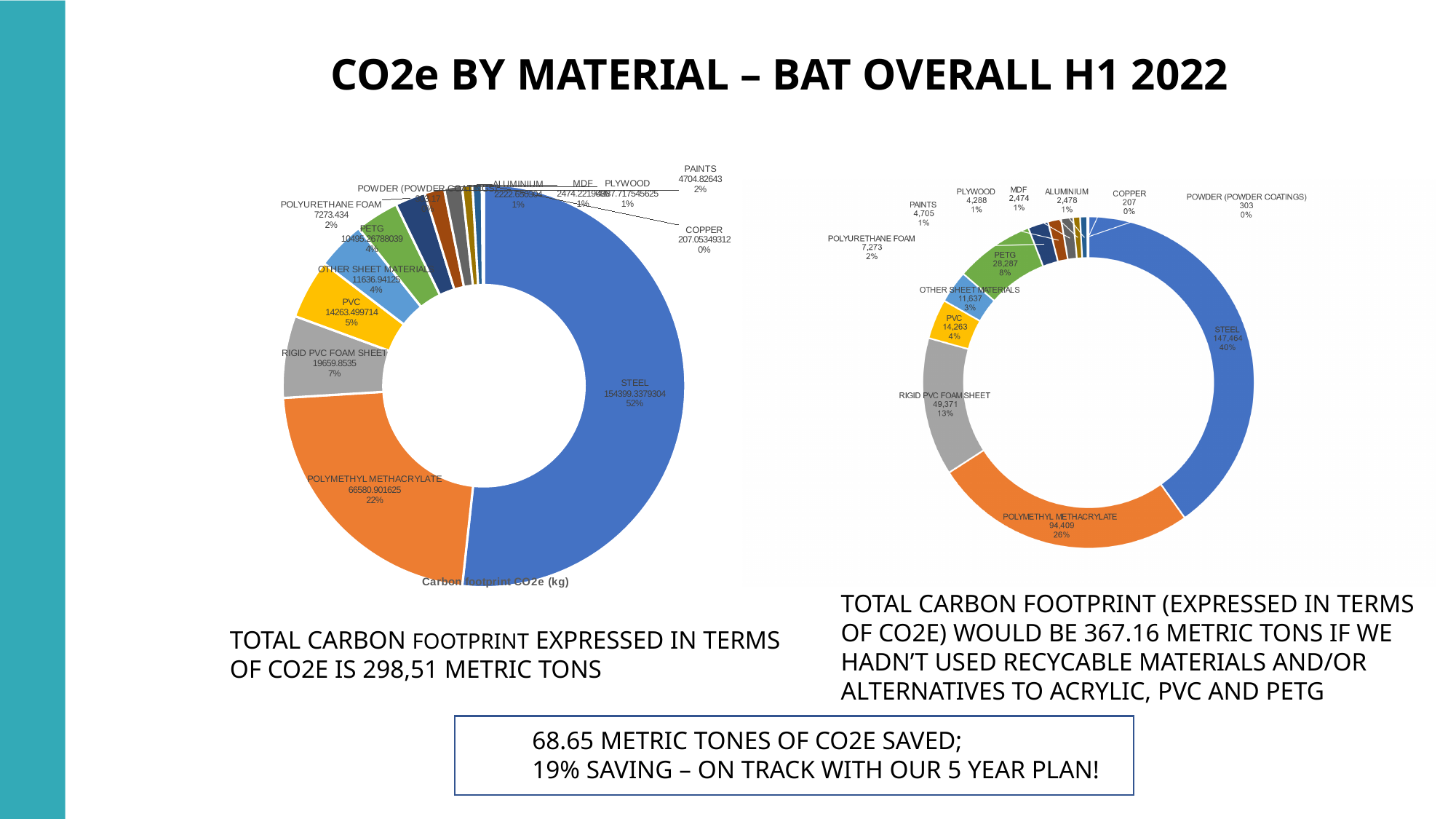
In the right-hand doughnut chart, what share of the total does POLYMETHYL METHACRYLATE represent? 26% What is the axis/series label printed below the left-hand doughnut chart? Carbon footprint CO2e (kg) In the left-hand doughnut chart, what percentage share does RIGID PVC FOAM SHEET have? 7% In the right-hand doughnut chart, which material has the largest slice? STEEL What type of chart is shown on the left of the slide? Doughnut (pie) chart In the right-hand doughnut chart, which is larger: the value for PLYWOOD or the value for MDF? PLYWOOD In the right-hand doughnut chart, which material has the smallest value? COPPER In the left-hand doughnut chart, what percentage share does STEEL have? 52% In the right-hand doughnut chart, what is the difference between the values for PETG and PVC? 14,024 In the right-hand doughnut chart, what is the value for STEEL? 147,464 In the right-hand doughnut chart, what is the value for RIGID PVC FOAM SHEET? 49,371 How many material categories are shown in the right-hand doughnut chart? 13